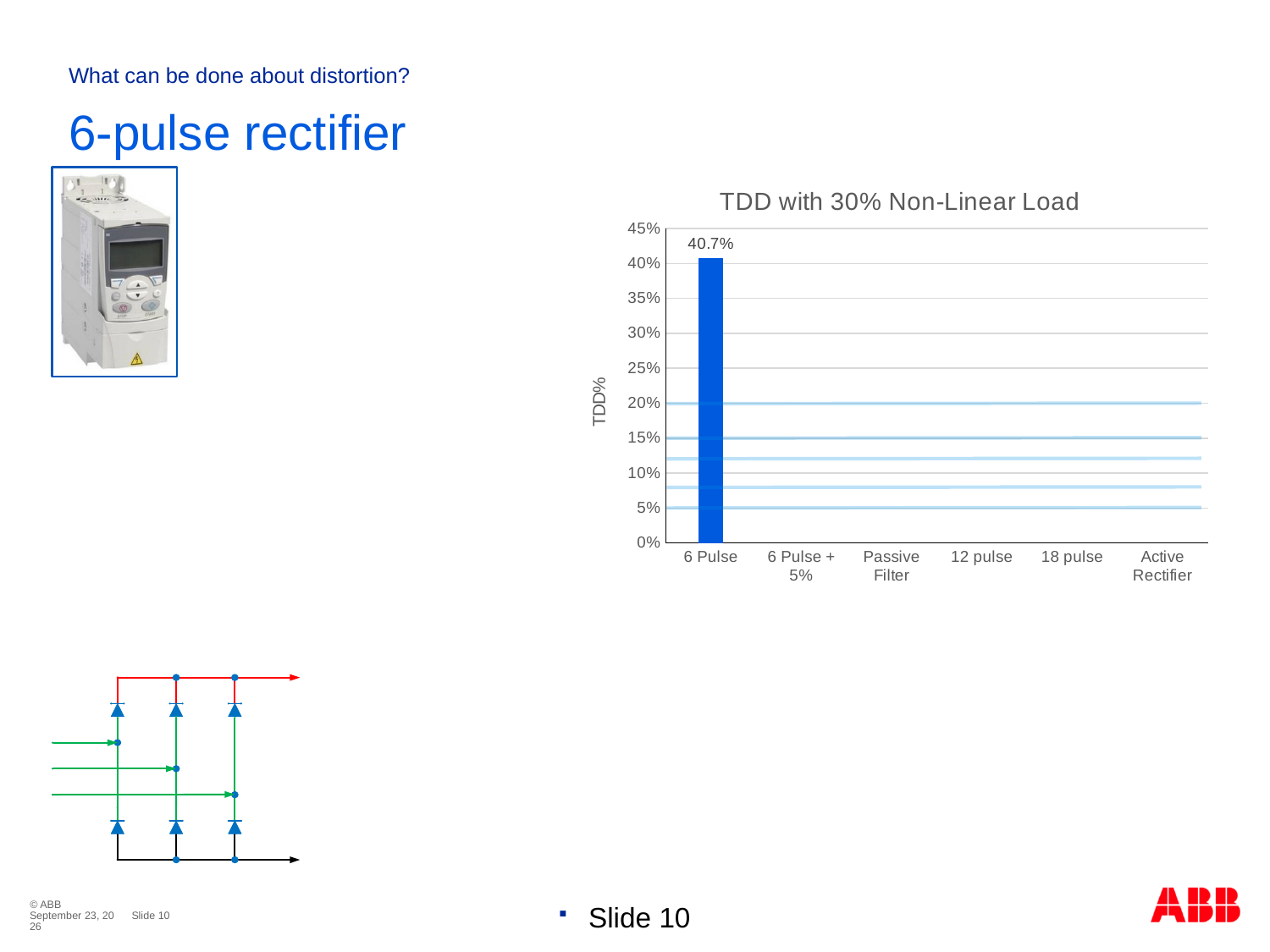
What is the last category listed on the x axis of the chart? Active Rectifier What is the TDD value shown for 6 Pulse? 40.7% How many categories are listed along the x axis of the chart? 6 What is the highest value shown on the vertical axis of the chart? 45% What is the title of the chart? TDD with 30% Non-Linear Load What kind of chart is shown on the slide? bar chart Is the value for 6 Pulse greater or less than 45%? less Is the value for 6 Pulse greater or less than 40%? greater What is the label on the vertical axis of the chart? TDD% Which category is the only one with a bar plotted in the chart? 6 Pulse